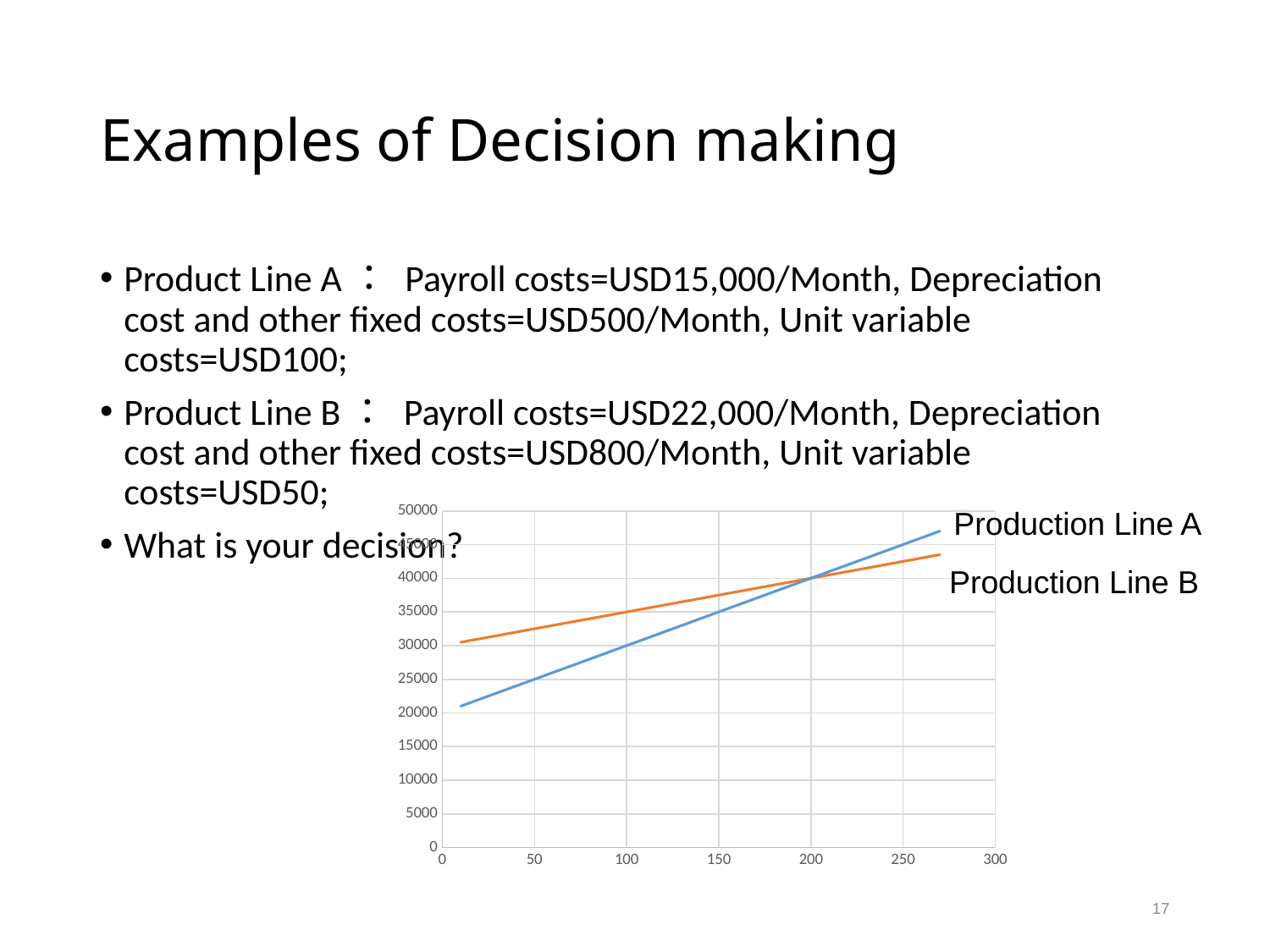
At x = 250, which line has the higher value, Production Line A or Production Line B? Production Line A At x = 50, which line has the higher value, Production Line A or Production Line B? Production Line B What kind of chart is shown on the slide? line chart Is the value for Production Line B at x = 250 greater or less than 45000? less What is the highest value shown on the y axis of the chart? 50000 How many lines (series) are plotted on the chart? 2 Which line has the steeper slope, Production Line A or Production Line B? Production Line A Is the value for Production Line B at x = 100 greater or less than 30000? greater Do the values for Production Line A rise or fall as the x axis increases? rise Do the values for Production Line B rise or fall as the x axis increases? rise Is the value for Production Line A at x = 100 greater or less than 25000? greater